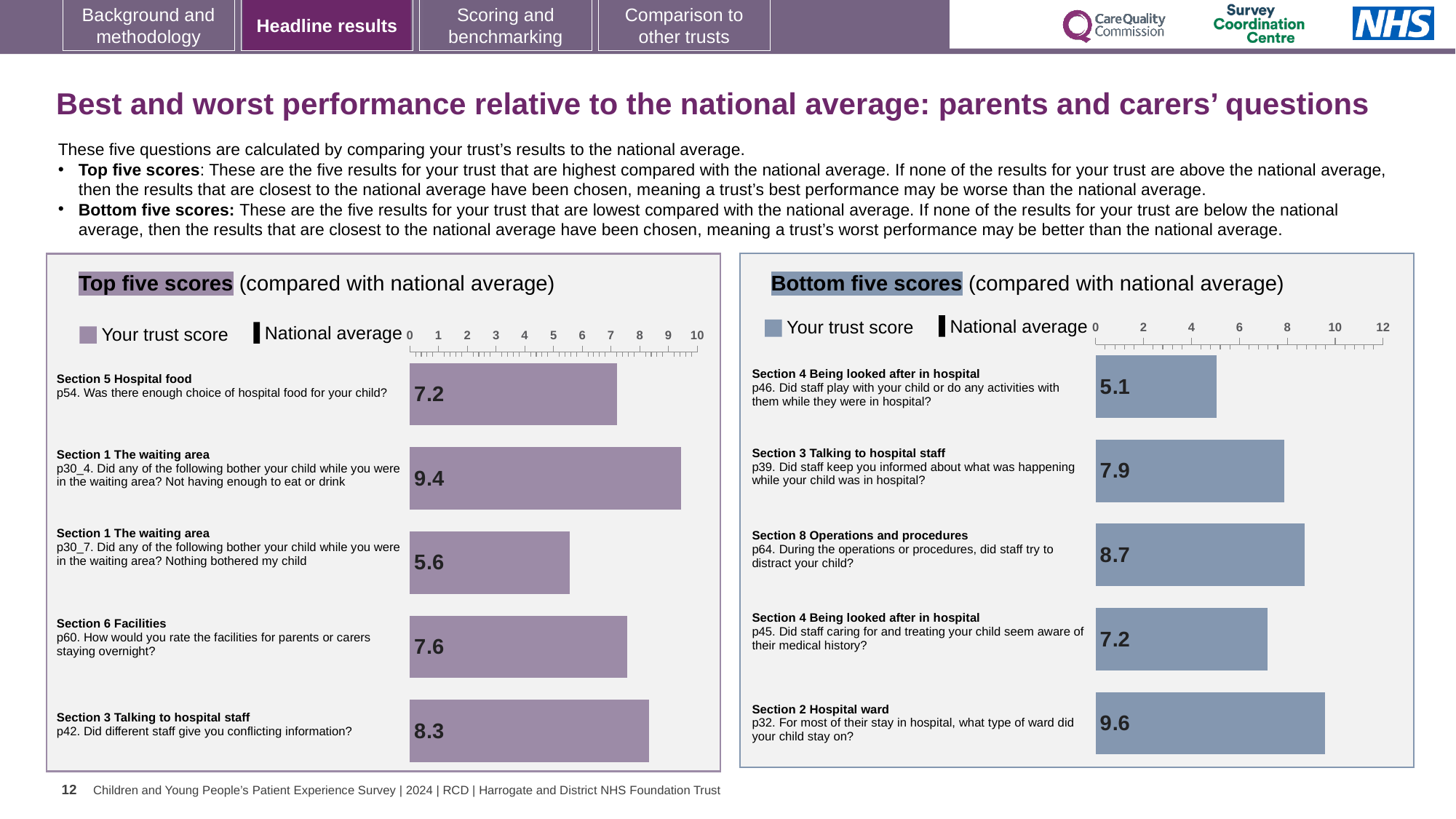
In the Bottom five scores chart, which question has the highest trust score? p32. For most of their stay in hospital, what type of ward did your child stay on? In the Top five scores chart, which question has the highest trust score? p30_4. Did any of the following bother your child while you were in the waiting area? Not having enough to eat or drink In the Bottom five scores chart, which question has the lowest trust score? p46. Did staff play with your child or do any activities with them while they were in hospital? In the Bottom five scores chart, is the trust score for p64 larger or smaller than the trust score for p39? larger How many entries does the legend of the Bottom five scores chart list? 2 In the Top five scores chart, which question has the lowest trust score? p30_7. Did any of the following bother your child while you were in the waiting area? Nothing bothered my child In the Top five scores chart, what is the trust score for p54 (Was there enough choice of hospital food for your child?)? 7.2 In the Top five scores chart, how many questions are plotted? 5 In the Bottom five scores chart, what is the trust score for p46 (Did staff play with your child or do any activities with them while they were in hospital?)? 5.1 In the Top five scores chart, what is the difference between the trust scores for p42 and p60? 0.7 In the Bottom five scores chart, what is the difference between the trust scores for p32 and p46? 4.5 What type of chart is used in the Top five scores panel? Bar chart